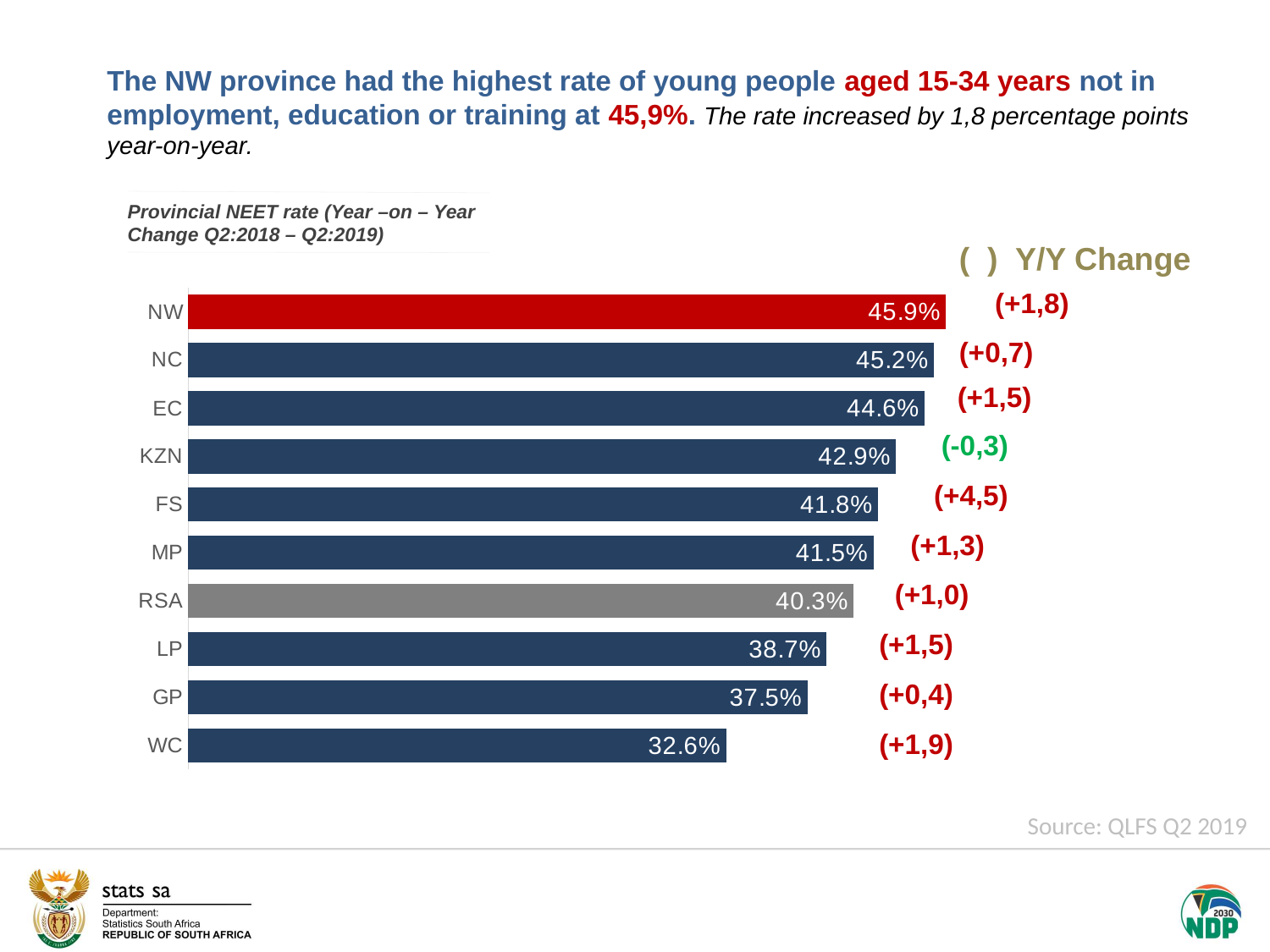
What is the difference between the NEET rates of NC and EC? 0.6 percentage points What is the NEET rate for WC? 32.6% What kind of chart is shown on the slide? Bar chart Which province shows a negative year-on-year change? KZN What is the NEET rate for RSA? 40.3% What is the difference between the NEET rates of NW and WC? 13.3 percentage points Which province has the lowest NEET rate? WC How many bars are shown in the chart? 10 What is the NEET rate for KZN? 42.9% What is the NEET rate for NW? 45.9% Which has a higher NEET rate, FS or GP? FS Which province has the highest NEET rate? NW